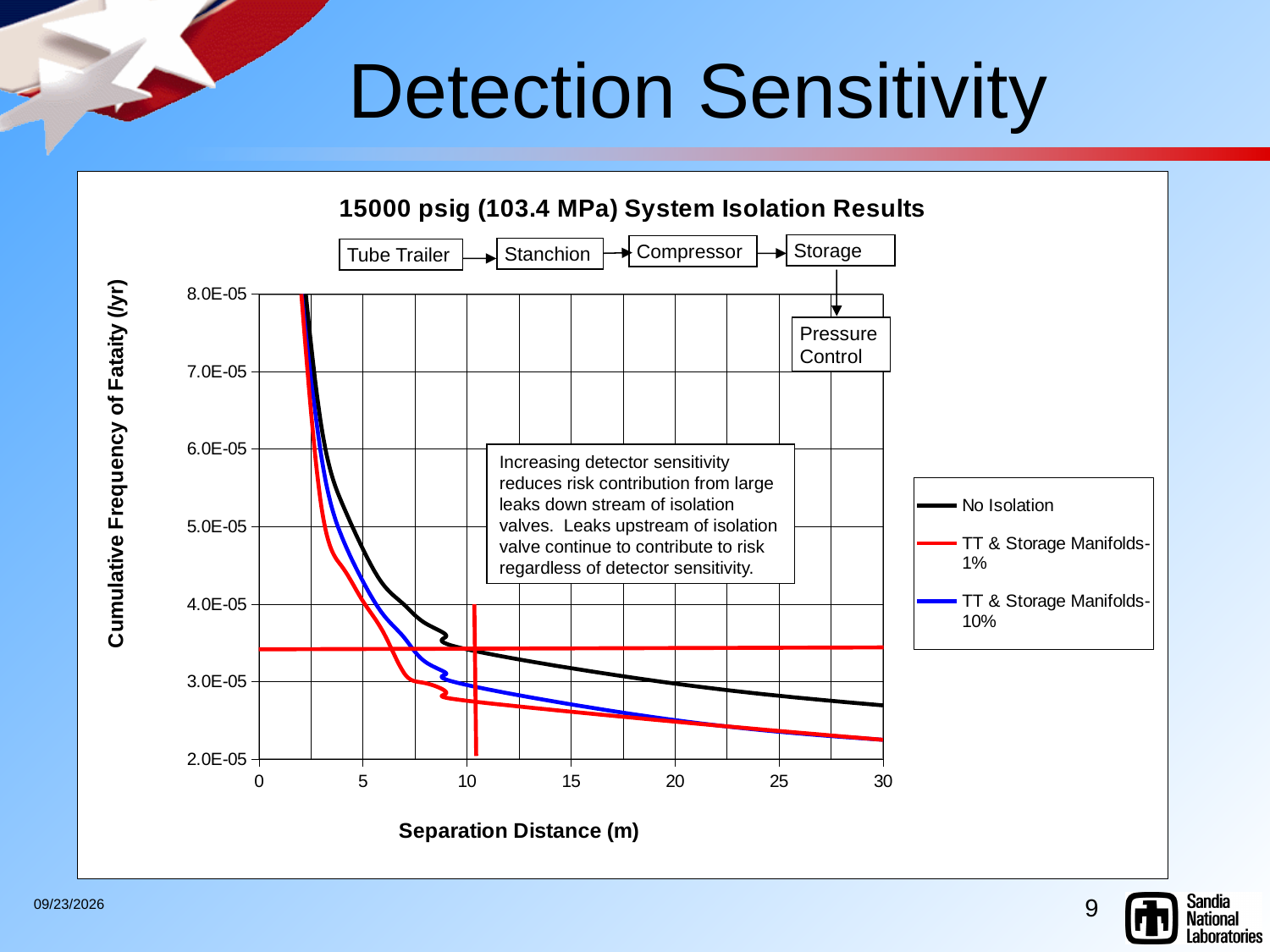
Is the value for No Isolation at 10 m greater or less than 4.0E-05? less How many series does the chart legend list? 3 What is the label of the x axis of the chart? Separation Distance (m) Is the value for TT & Storage Manifolds-1% at 10 m greater or less than 3.0E-05? less What kind of chart is shown on the slide? Line chart Is the value for No Isolation at 30 m greater or less than 3.0E-05? less Do the plotted values rise or fall as separation distance increases? Fall What is the title of the chart? 15000 psig (103.4 MPa) System Isolation Results At a separation distance of 10 m, which is larger: No Isolation or TT & Storage Manifolds-1%? No Isolation Which series has the highest value at a separation distance of 30 m? No Isolation Which series has the lowest value at a separation distance of 10 m? TT & Storage Manifolds-1%